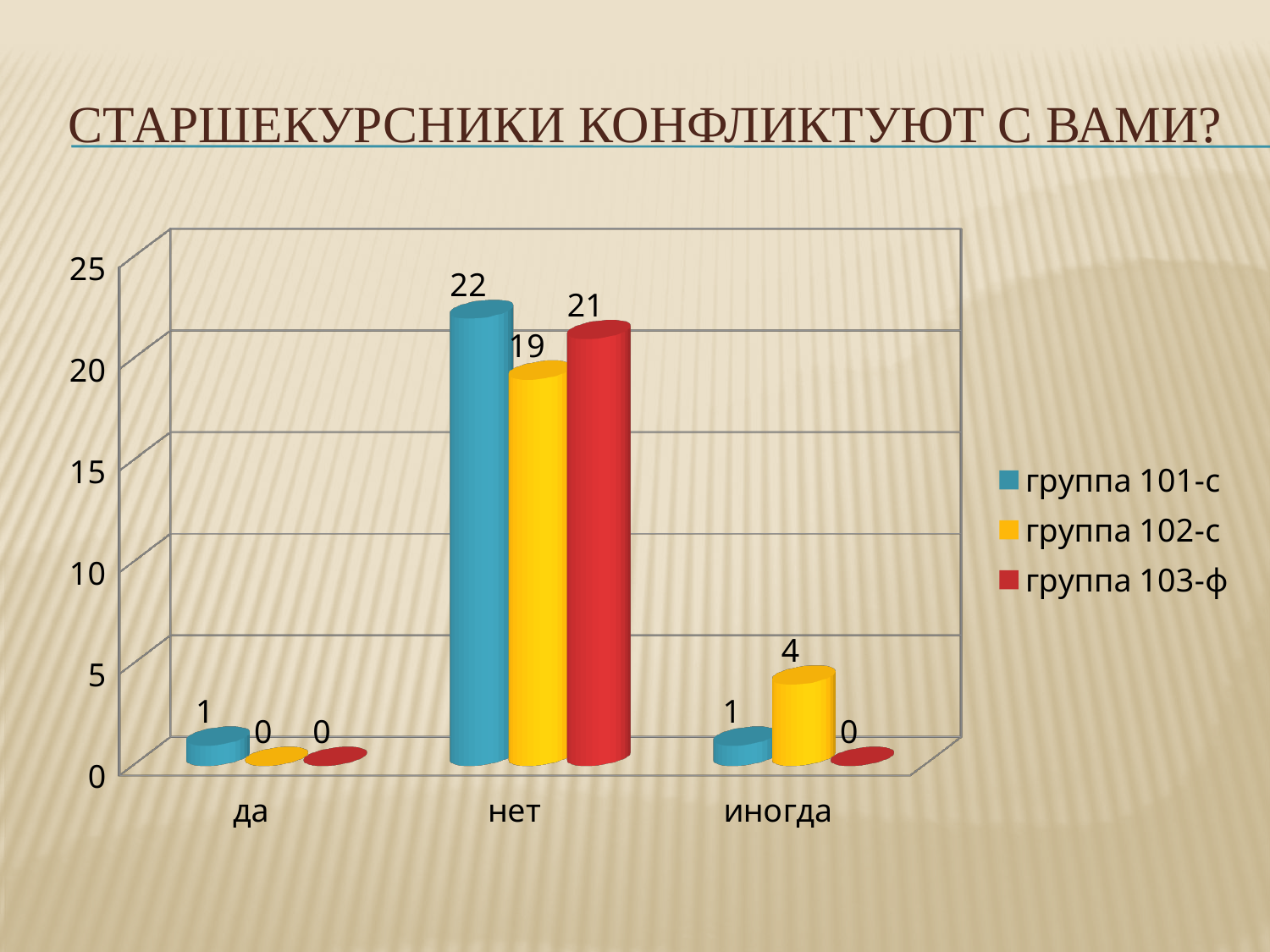
What is the value for группа 102-с in the нет category? 19 How many series does the legend list? 3 Which category has the highest value for группа 103-ф? нет Which is larger in the иногда category: группа 101-с or группа 102-с? группа 102-с How many categories are shown on the x axis? 3 What is the value for группа 101-с in the нет category? 22 What is the value for группа 101-с in the да category? 1 What is the difference between группа 101-с and группа 102-с in the нет category? 3 Which series has the highest value in the нет category? группа 101-с What kind of chart is shown on the slide? bar chart What is the value for группа 103-ф in the нет category? 21 What is the value for группа 102-с in the иногда category? 4